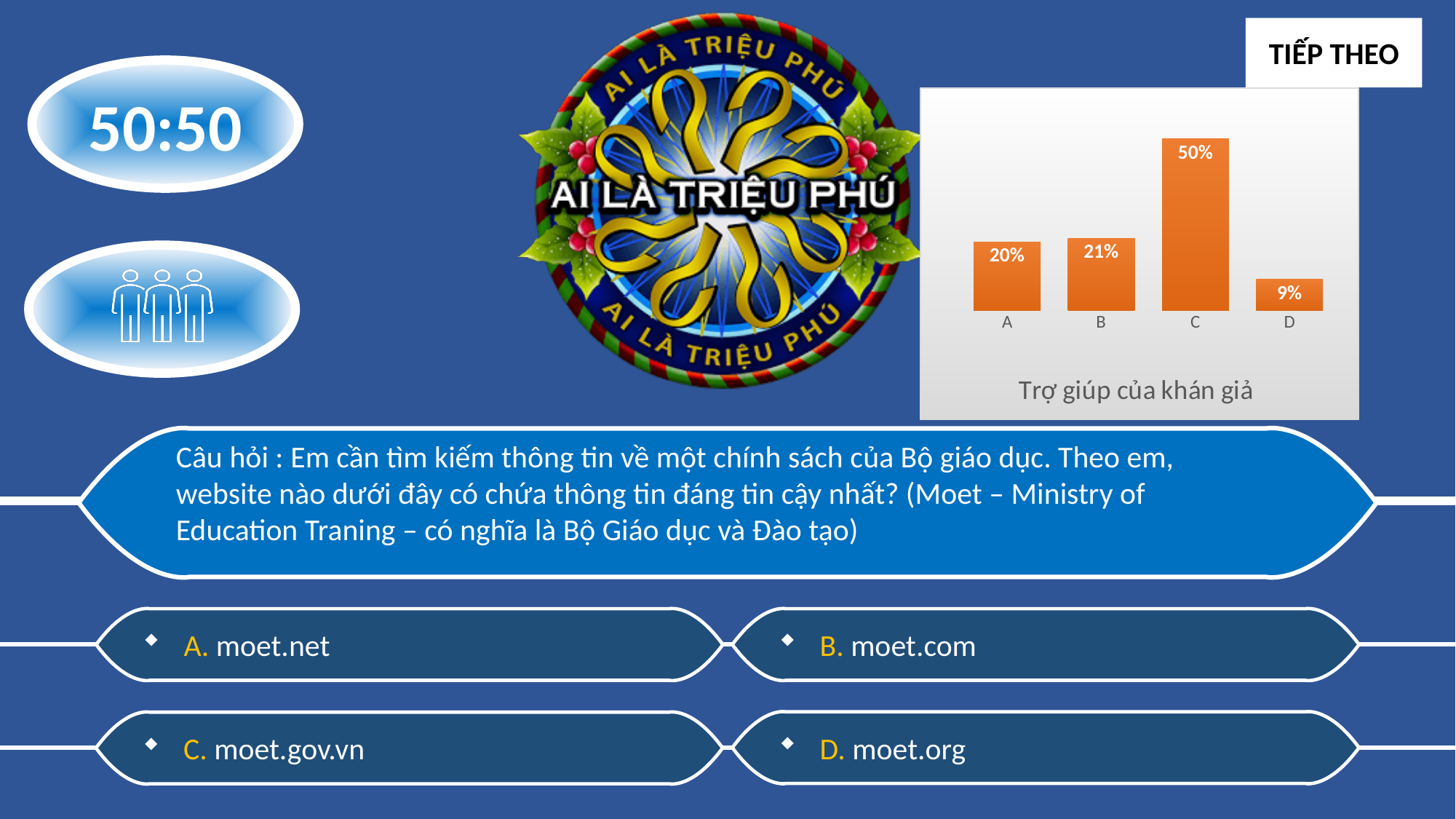
What is the value for category B in the chart? 21% Which is larger, the value for C or the value for A? C What is the title of the chart? Trợ giúp của khán giả What is the value for category A in the chart? 20% Which category has the highest value in the chart? C What is the difference between the values for C and D? 41% What is the value for category C in the chart? 50% What is the value for category D in the chart? 9% Which category has the lowest value in the chart? D What is the difference between the values for B and A? 1% How many categories are shown in the chart? 4 What kind of chart is shown on the slide? Bar chart